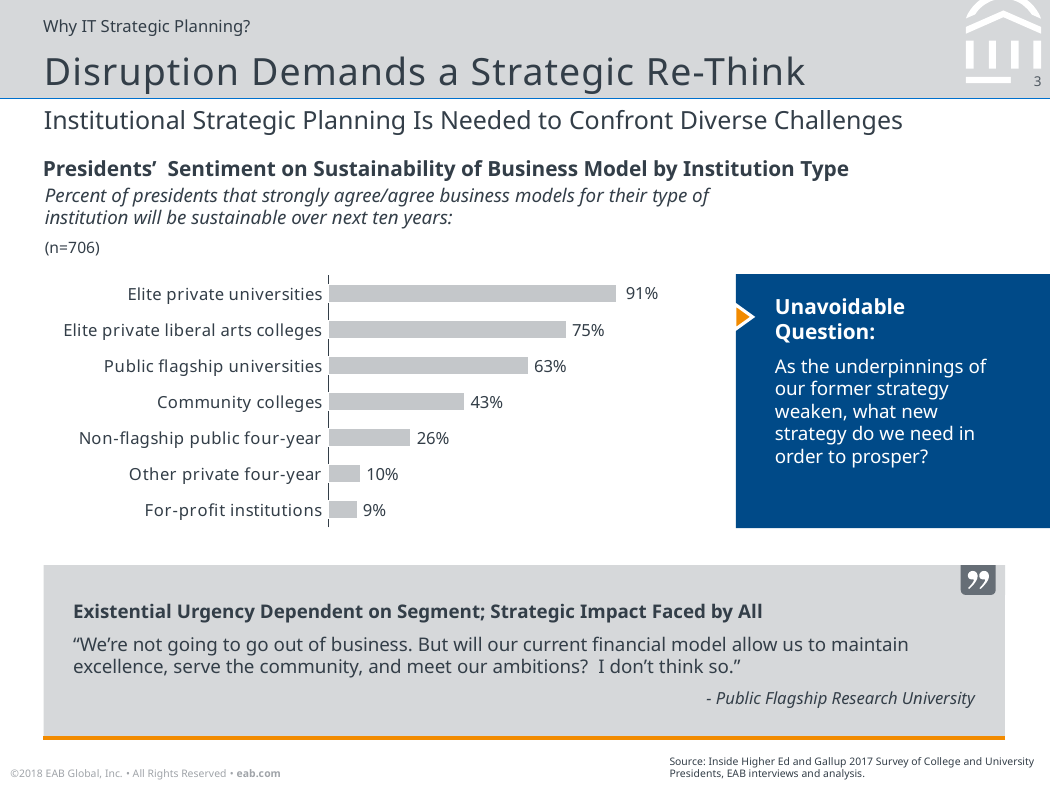
What is the value shown for community colleges? 43% What is the sample size (n) noted for the chart? 706 How many institution types are shown in the chart? 7 What kind of chart is shown on the slide? Bar chart Which institution type has the highest percentage? Elite private universities What is the difference between the values for elite private liberal arts colleges and public flagship universities? 12% What is the title of the chart? Presidents' Sentiment on Sustainability of Business Model by Institution Type What is the value shown for non-flagship public four-year institutions? 26% Which institution type has the lowest percentage? For-profit institutions Which is larger, the value for other private four-year or for community colleges? Community colleges What is the difference between the values for elite private universities and for-profit institutions? 82% What percentage of presidents at elite private universities agree their business model will be sustainable? 91%